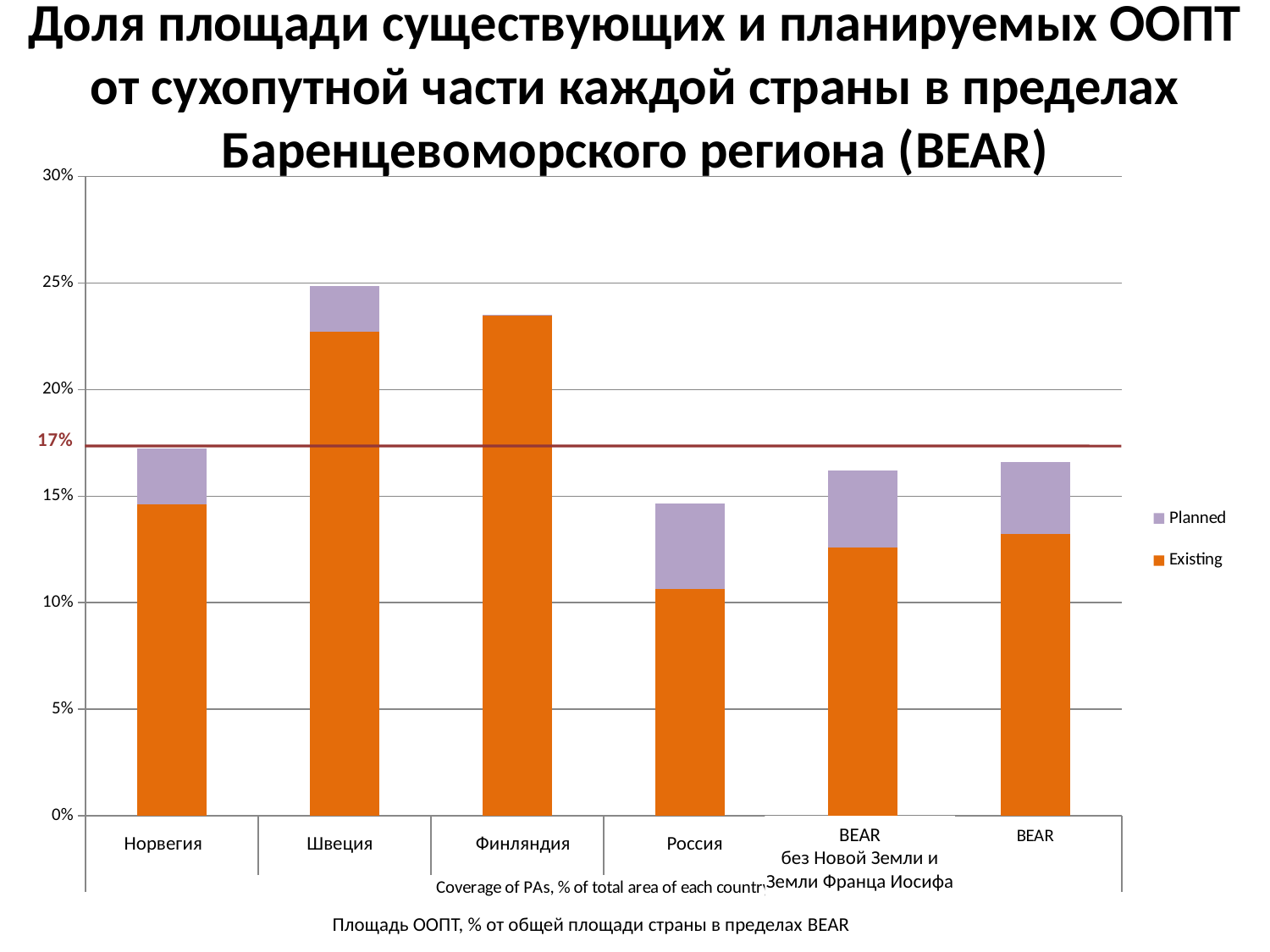
Which has the larger Planned segment, Россия or Финляндия? Россия Is the Existing value for Финляндия greater or less than 20%? greater Which category has the lowest total (Existing plus Planned) bar? Россия Which category has the smallest Existing segment? Россия Is the total bar for Швеция greater or less than 20%? greater How many categories are shown on the x axis of the chart? 6 What kind of chart is shown on the slide? Stacked bar chart Which series are listed in the chart legend? Planned and Existing What value is labelled on the horizontal reference line drawn across the chart? 17% Is the total bar for BEAR greater or less than 20%? less Which category has the highest total (Existing plus Planned) bar? Швеция How many series does the chart legend list? 2